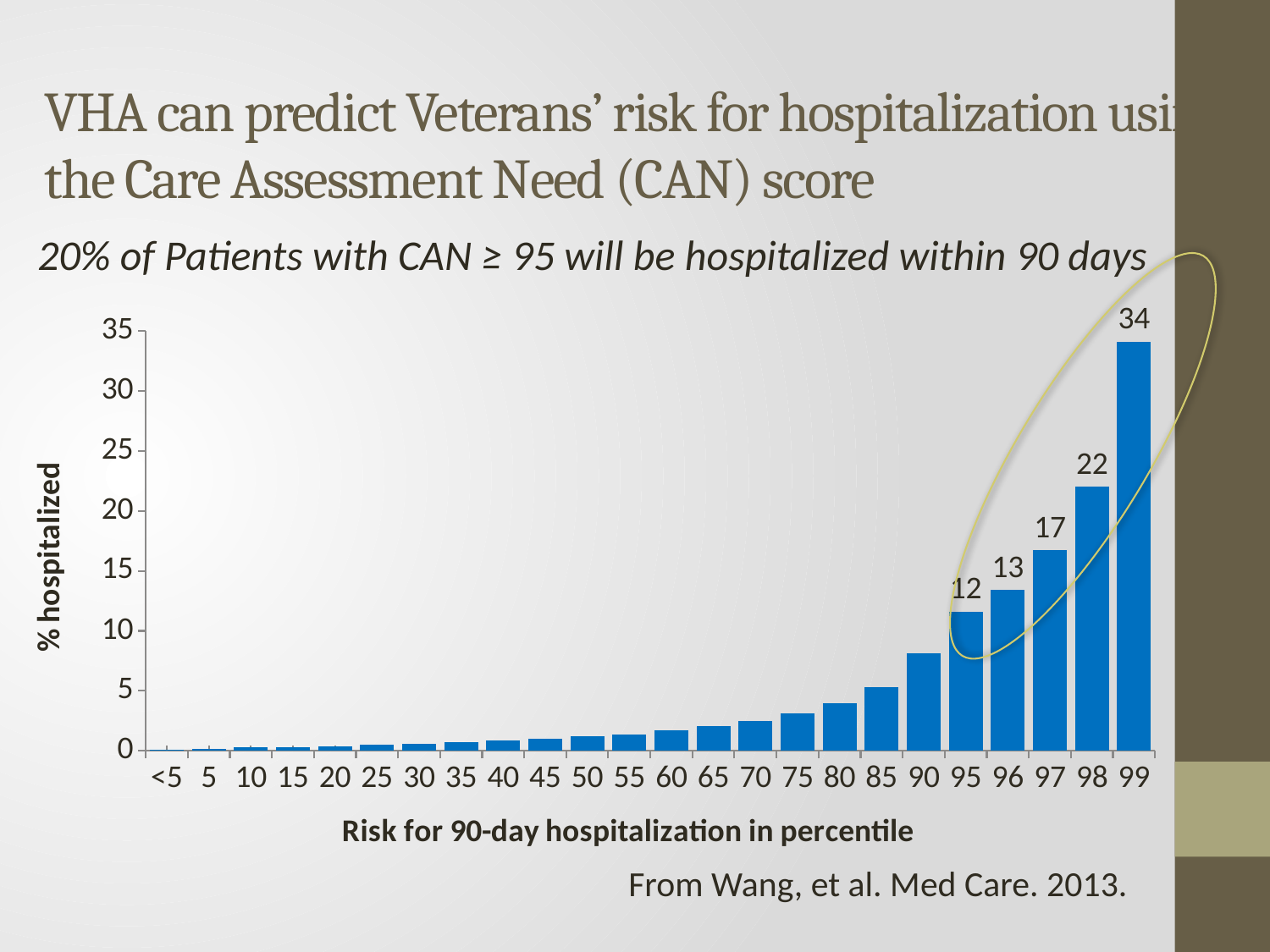
Which percentile category has the highest % hospitalized? 99 Which has a higher % hospitalized, the 96th or the 98th percentile? 98 Do the values rise or fall as the risk percentile increases along the x axis? rise How many percentile categories are shown on the x axis? 24 What kind of chart is shown on the slide? bar chart What is the % hospitalized for the 99th percentile? 34 Is the % hospitalized for the 90th percentile greater or less than 10? less What is the % hospitalized for the 97th percentile? 17 Is the % hospitalized for the 80th percentile greater or less than 5? less What is the difference in % hospitalized between the 98th and 97th percentiles? 5 What is the difference in % hospitalized between the 99th and 98th percentiles? 12 What is the % hospitalized for the 95th percentile? 12